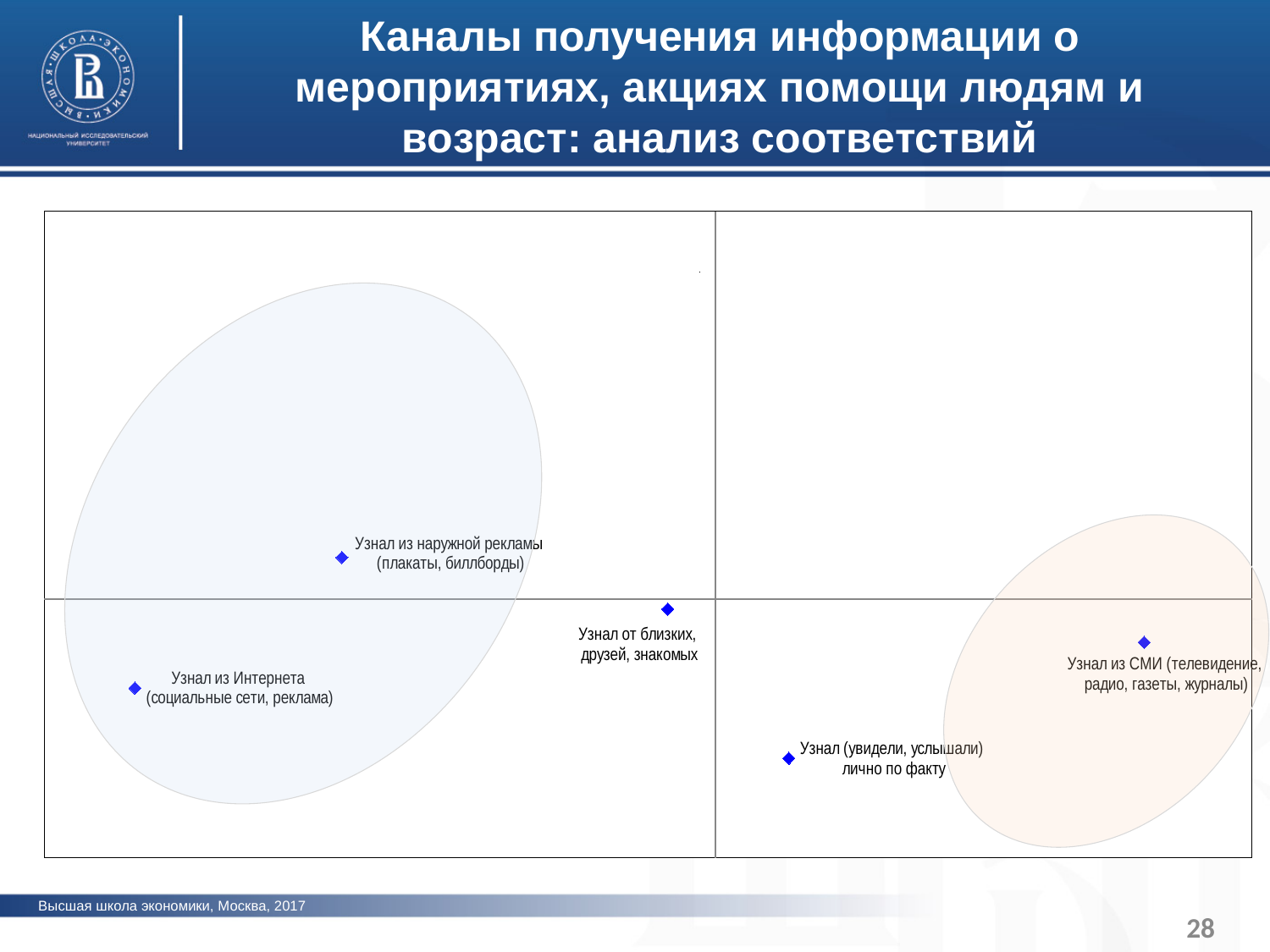
Which point is further to the right: 'Узнал из СМИ' or 'Узнал (увидели, услышали) лично по факту'? Узнал из СМИ Which data point is enclosed by the ellipse on the right side of the chart? Узнал из СМИ (телевидение, радио, газеты, журналы) Which data point is positioned furthest to the right on the chart? Узнал из СМИ (телевидение, радио, газеты, журналы) Which point is higher on the chart: 'Узнал из наружной рекламы' or 'Узнал из Интернета'? Узнал из наружной рекламы How many data points are plotted on the chart? 5 Which data point is positioned furthest to the left on the chart? Узнал из Интернета (социальные сети, реклама) What kind of chart is shown on the slide? Scatter chart How many shaded ellipses are drawn on the chart? 2 Which data point is positioned lowest on the chart? Узнал (увидели, услышали) лично по факту How many data points lie to the right of the vertical axis line? 2 How many data points lie in the upper-left quadrant of the chart? 1 Which data point is positioned highest on the chart? Узнал из наружной рекламы (плакаты, биллборды)